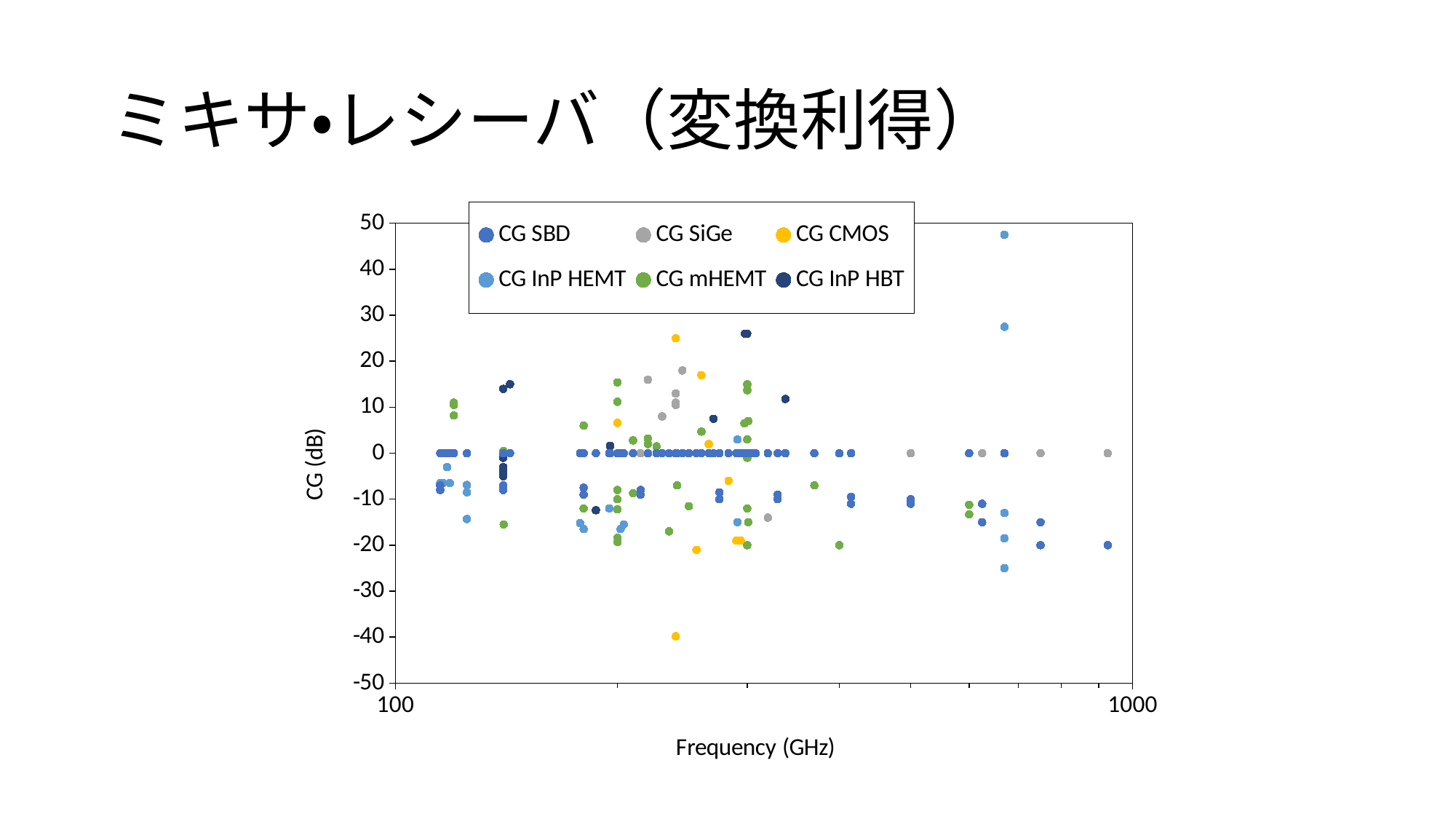
Is the highest CG CMOS point greater or less than 20 dB? greater Which series contains the highest plotted point on the chart? CG InP HEMT How many series does the legend list? 6 What is the label of the vertical axis? CG (dB) What kind of chart is shown on the slide? scatter chart Is the highest plotted point on the chart greater or less than 40 dB? greater Is the highest CG SiGe point higher or lower than the highest CG InP HEMT point? lower Is the lowest plotted point on the chart greater or less than -30 dB? less Which series contains the lowest plotted point on the chart? CG CMOS What is the label of the horizontal axis? Frequency (GHz) What is the maximum value shown on the vertical axis? 50